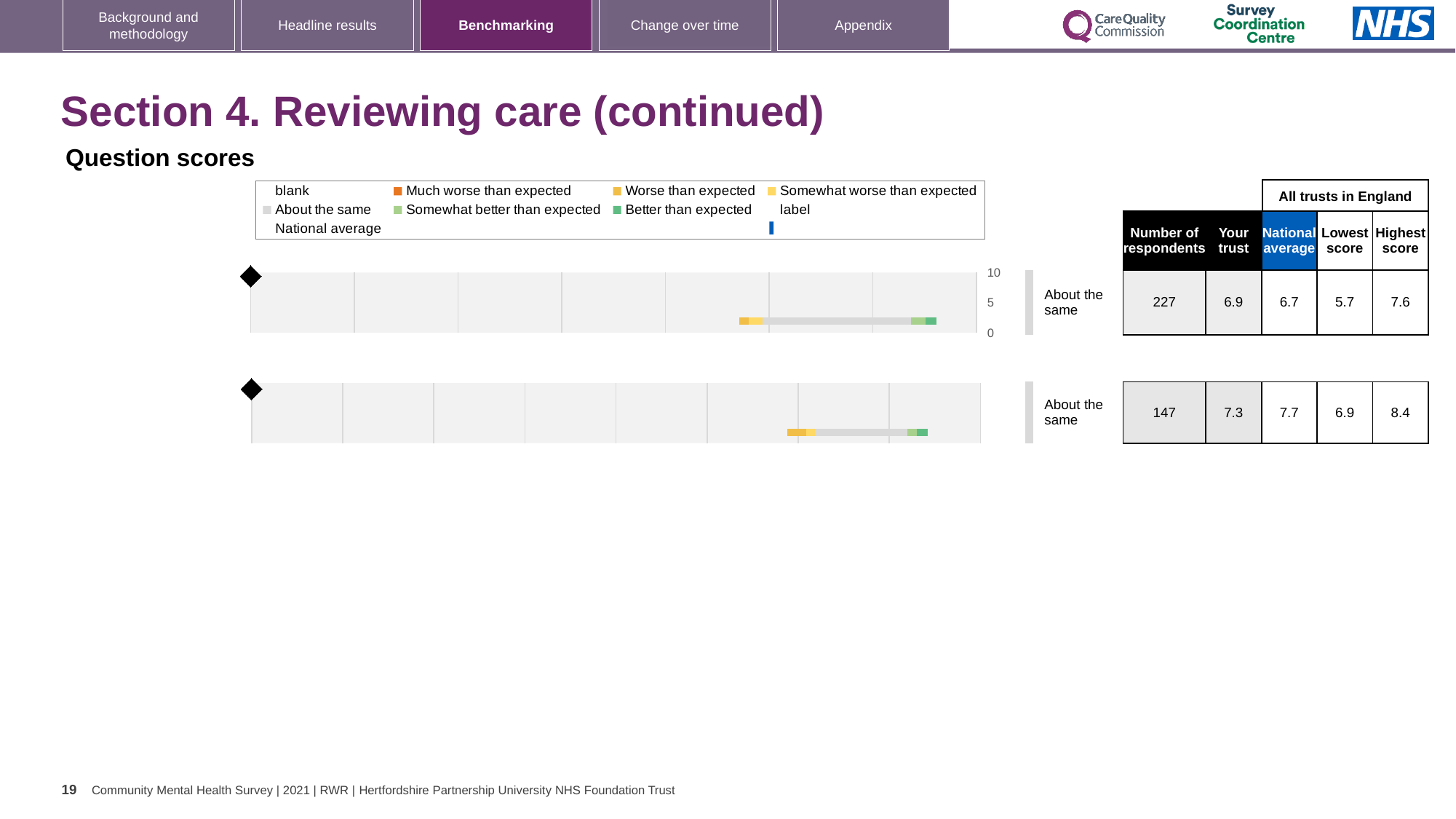
In the legend, what colour represents 'Much worse than expected'? orange Which chart's row has the higher number of respondents, the top or the bottom? top For the top chart, what is the number of respondents shown in the table? 227 What is the heading printed above the charts? Question scores For the top chart, which is larger: the 'Your trust' score or the national average? Your trust For the top chart, what is the national average score shown in the table? 6.7 How many question score charts are shown on the slide? 2 What kind of chart is used to show the question scores on this slide? bar chart For the bottom chart, what is the difference between the highest score and the lowest score in the table? 1.5 For the bottom chart, what is the 'Your trust' score shown in the table? 7.3 What benchmark category label is printed next to the top chart? About the same For the bottom chart, which is larger: the 'Your trust' score or the national average? National average